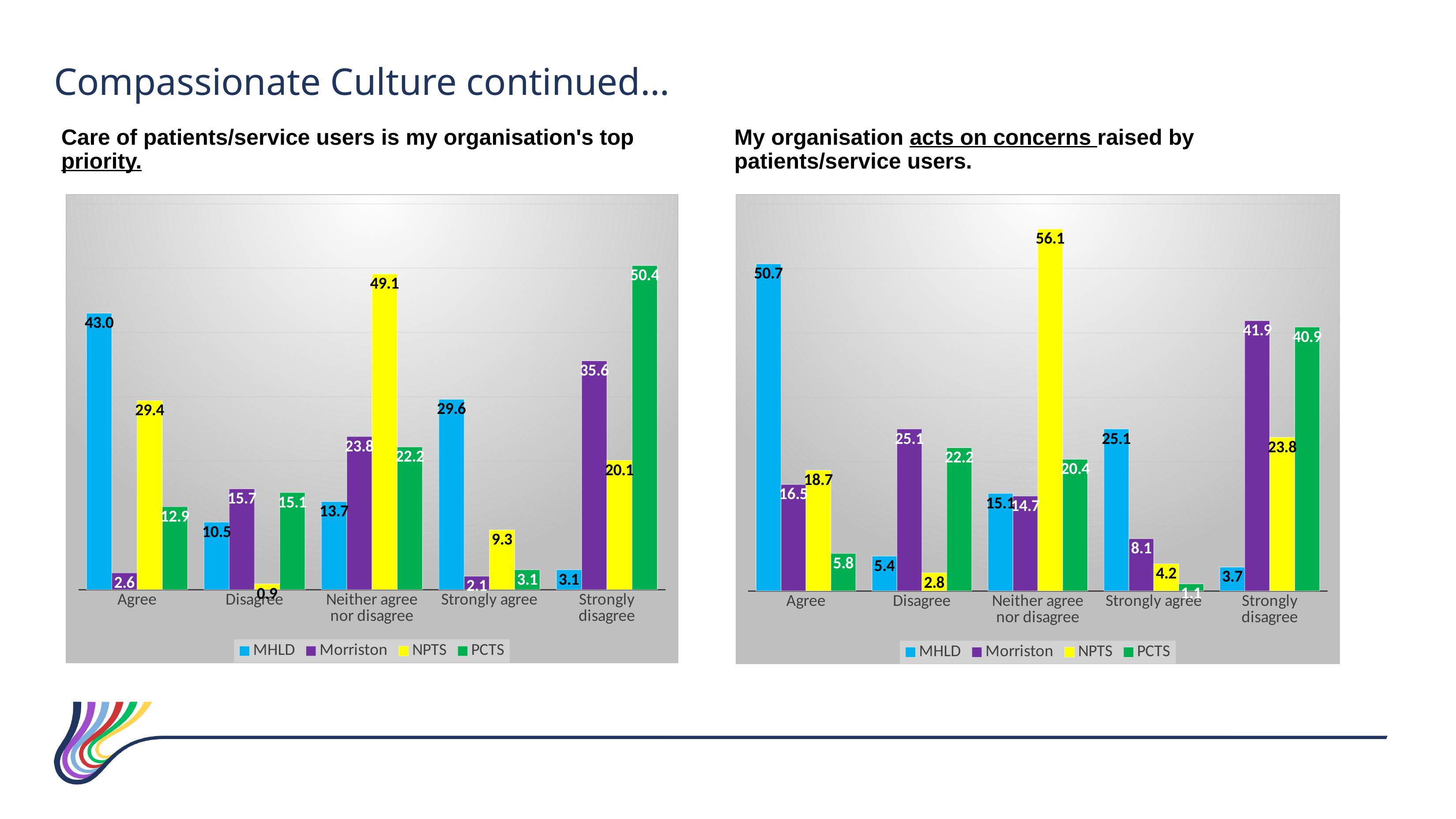
In the left chart (Care of patients/service users is my organisation's top priority), what is the value for NPTS under Neither agree nor disagree? 49.1 In the left chart (Care of patients/service users is my organisation's top priority), how many series does the legend list? 4 In the right chart (My organisation acts on concerns raised by patients/service users), which is larger under Strongly disagree: Morriston or NPTS? Morriston In the right chart (My organisation acts on concerns raised by patients/service users), which category has the highest MHLD value? Agree In the right chart (My organisation acts on concerns raised by patients/service users), what is the value for PCTS under Strongly agree? 1.1 In the left chart (Care of patients/service users is my organisation's top priority), which category has the lowest NPTS value? Disagree In the left chart (Care of patients/service users is my organisation's top priority), which category has the highest PCTS value? Strongly disagree In the left chart (Care of patients/service users is my organisation's top priority), what is the value for MHLD under Agree? 43.0 In the right chart (My organisation acts on concerns raised by patients/service users), what is the value for NPTS under Neither agree nor disagree? 56.1 In the right chart (My organisation acts on concerns raised by patients/service users), what is the difference between the MHLD and Morriston values under Agree? 34.2 In the left chart (Care of patients/service users is my organisation's top priority), what is the difference between the PCTS and Morriston values under Strongly disagree? 14.8 What kind of chart is the right chart (My organisation acts on concerns raised by patients/service users)? Bar chart